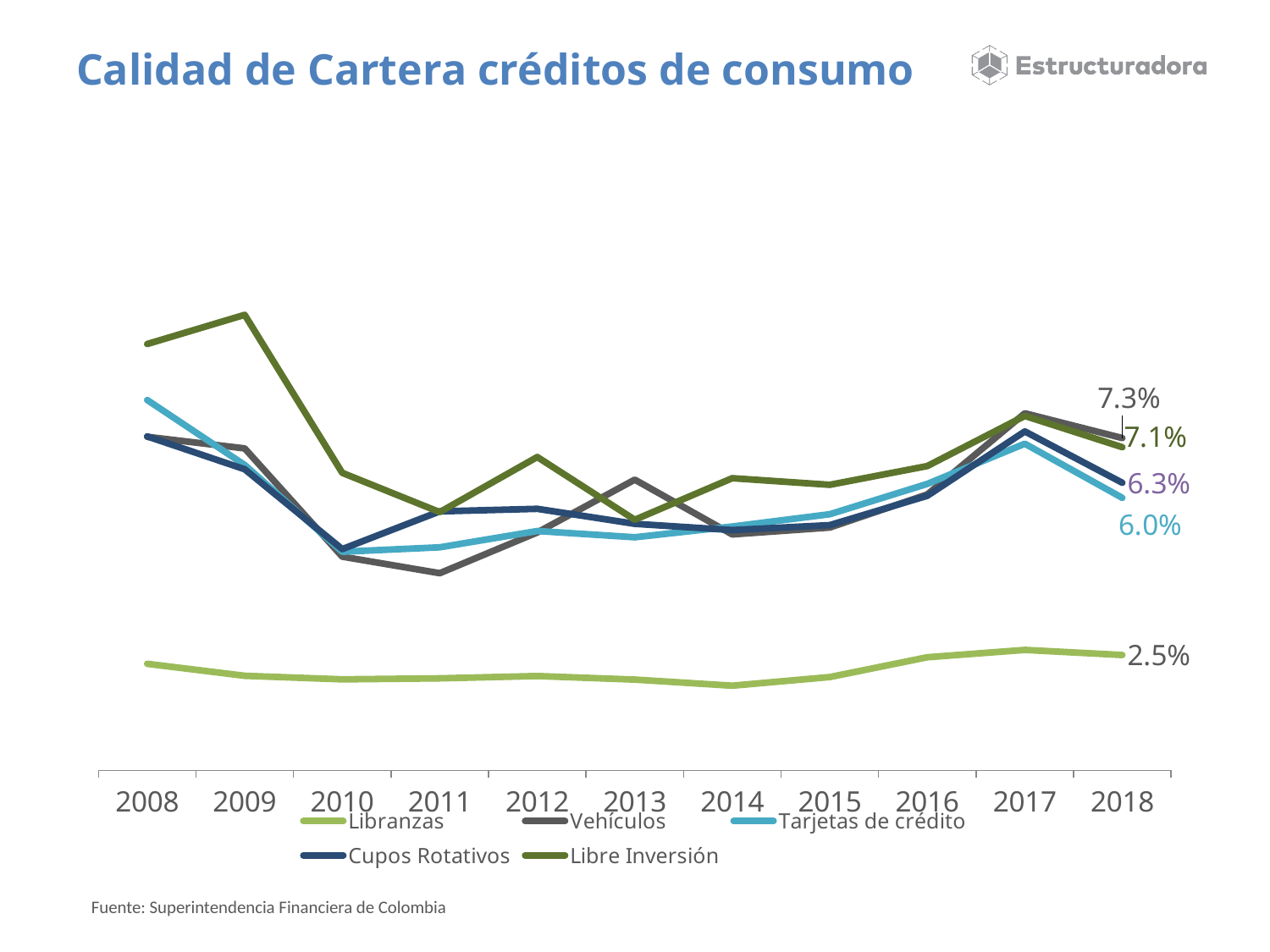
How many years are shown on the x axis? 11 What is the value for Vehículos in 2018? 7.3% Which series has the highest value in 2018? Vehículos Which series has the lowest value in 2018? Libranzas What is the difference between the 2018 values for Vehículos and Libranzas? 4.8% Does the Libre Inversión line rise or fall from 2009 to 2010? Fall What type of chart is shown on the slide? Line chart What is the value for Tarjetas de crédito in 2018? 6.0% What is the value for Libranzas in 2018? 2.5% What is the value for Cupos Rotativos in 2018? 6.3% What is the value for Libre Inversión in 2018? 7.1% How many series does the legend list? 5